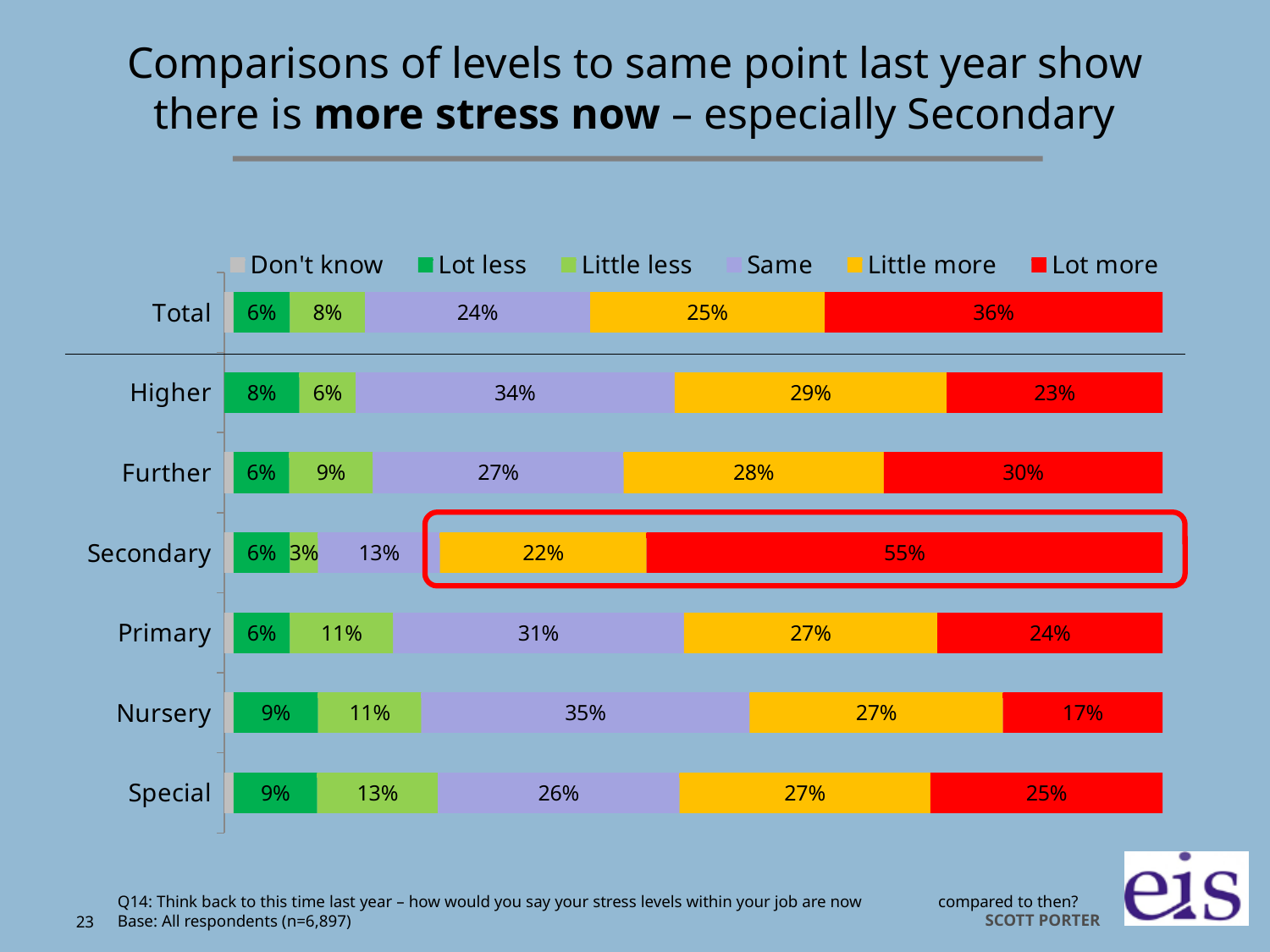
What is the 'Same' value for Nursery? 35% Which category has the highest 'Same' percentage? Nursery What is the 'Little more' value for Further? 28% How many series does the legend list? 6 What is the 'Little less' value for Special? 13% How many categories are shown on the vertical axis of the chart? 7 What type of chart is shown on the slide? Stacked bar chart Which category has the highest 'Lot more' percentage? Secondary How many percentage points higher is the 'Lot more' value for Secondary than for Total? 19 percentage points Which category has the lowest 'Lot more' percentage? Nursery What percentage of Secondary respondents said their stress is a 'Lot more'? 55% Which has a larger 'Same' value, Higher or Primary? Higher